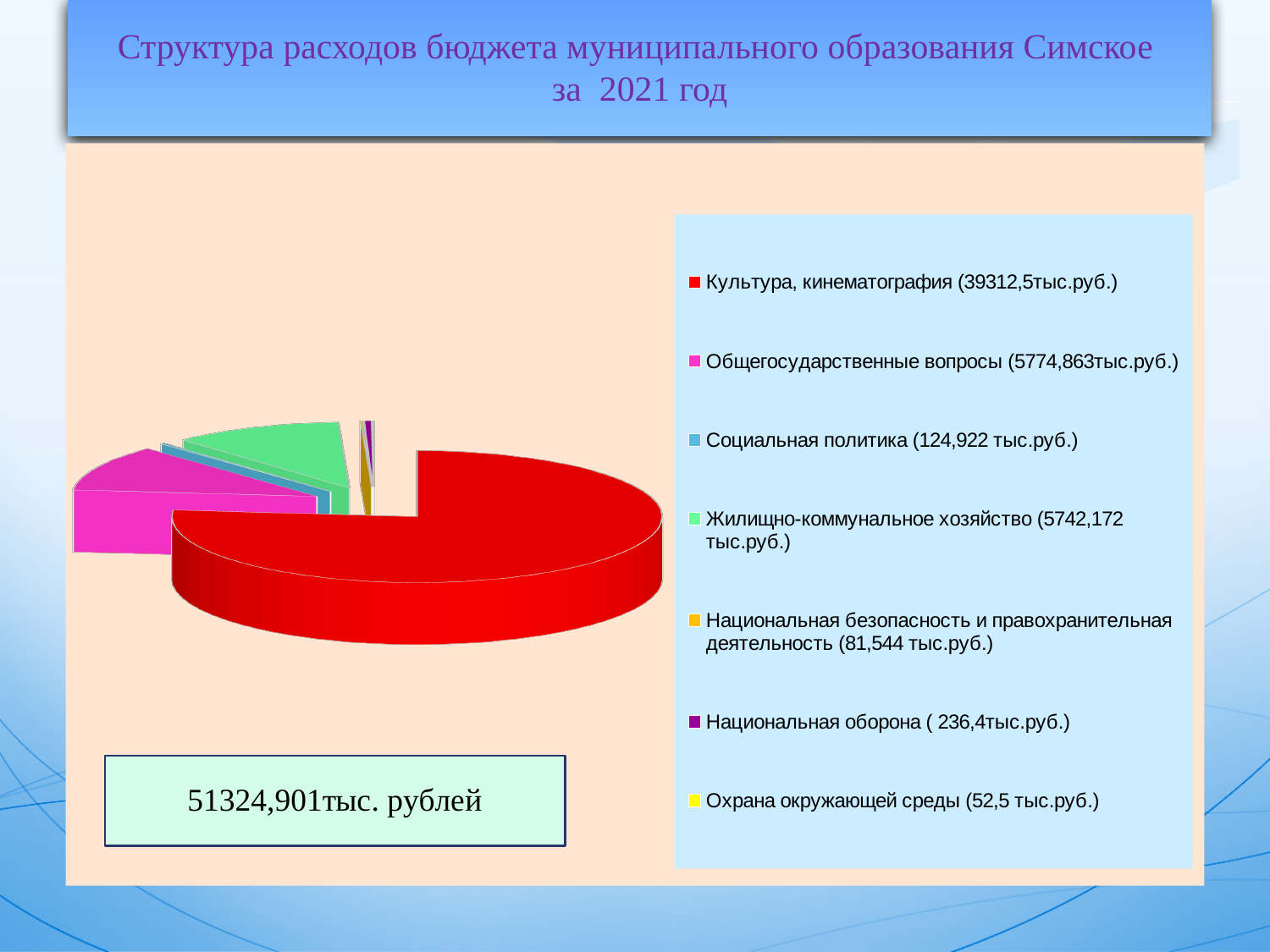
How many categories does the pie chart have? 7 Which is larger: Общегосударственные вопросы or Жилищно-коммунальное хозяйство? Общегосударственные вопросы What is the difference between Культура, кинематография and Общегосударственные вопросы? 33537,637 тыс.руб. What is the value for Культура, кинематография? 39312,5 тыс.руб. What is the value for Национальная оборона? 236,4 тыс.руб. What is the value for Общегосударственные вопросы? 5774,863 тыс.руб. What colour is the slice for Культура, кинематография? Red What kind of chart is shown on the slide? Pie chart Which category has the smallest value? Охрана окружающей среды What total expenditure is shown in the box below the chart? 51324,901тыс. рублей Which category has the largest share of the pie? Культура, кинематография What is the value for Социальная политика? 124,922 тыс.руб.